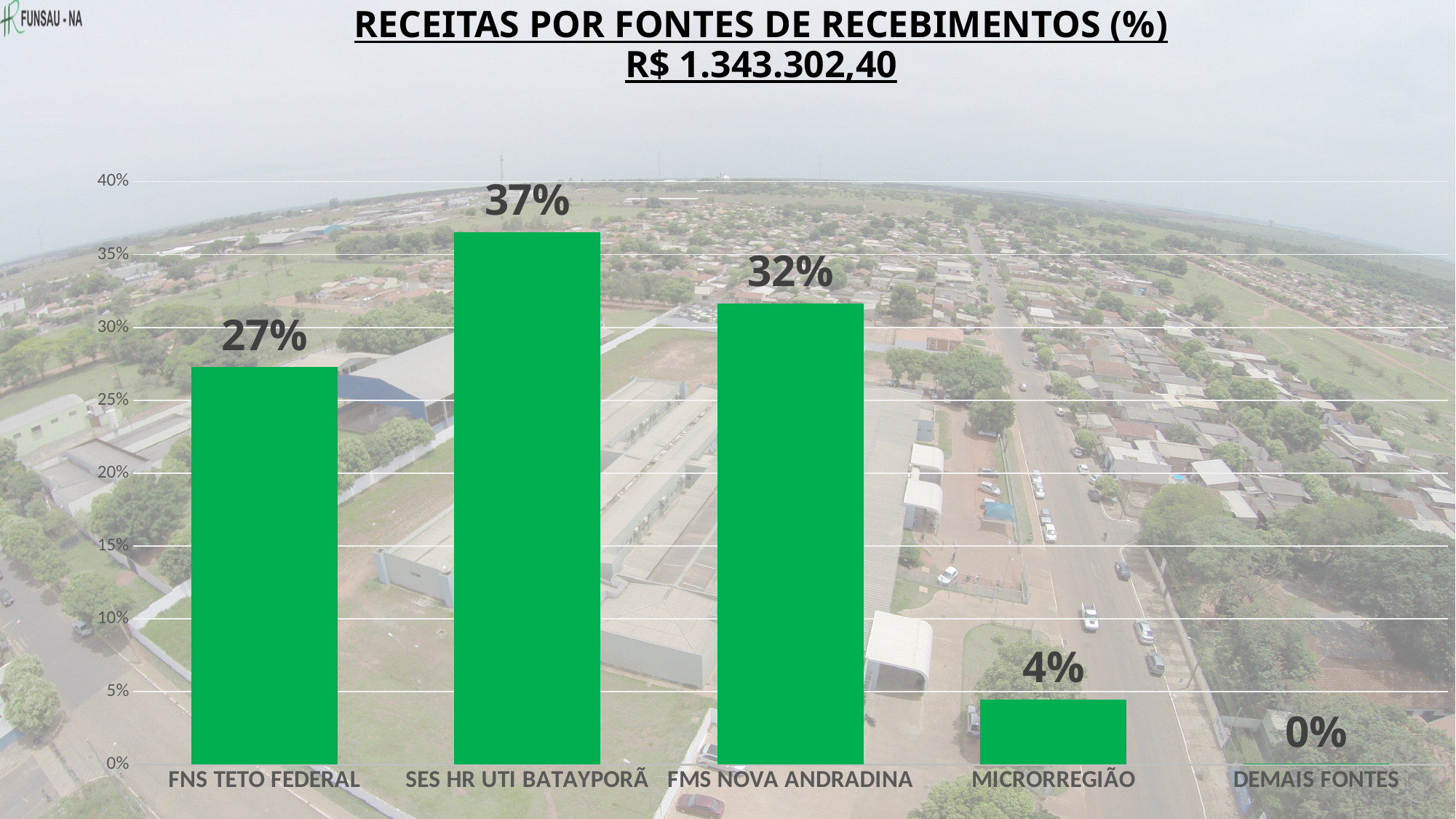
What kind of chart is shown on the slide? Bar chart What is the difference between the values for SES HR UTI BATAYPORÃ and FMS NOVA ANDRADINA? 5% Which category has the highest value? SES HR UTI BATAYPORÃ What is the title of the chart? RECEITAS POR FONTES DE RECEBIMENTOS (%) R$ 1.343.302,40 What is the value for FMS NOVA ANDRADINA? 32% Which is larger, the value for FNS TETO FEDERAL or the value for FMS NOVA ANDRADINA? FMS NOVA ANDRADINA What is the value for SES HR UTI BATAYPORÃ? 37% How many categories are shown on the x axis? 5 What is the value for DEMAIS FONTES? 0% What is the value for MICRORREGIÃO? 4% Which category has the lowest value? DEMAIS FONTES What is the value for FNS TETO FEDERAL? 27%